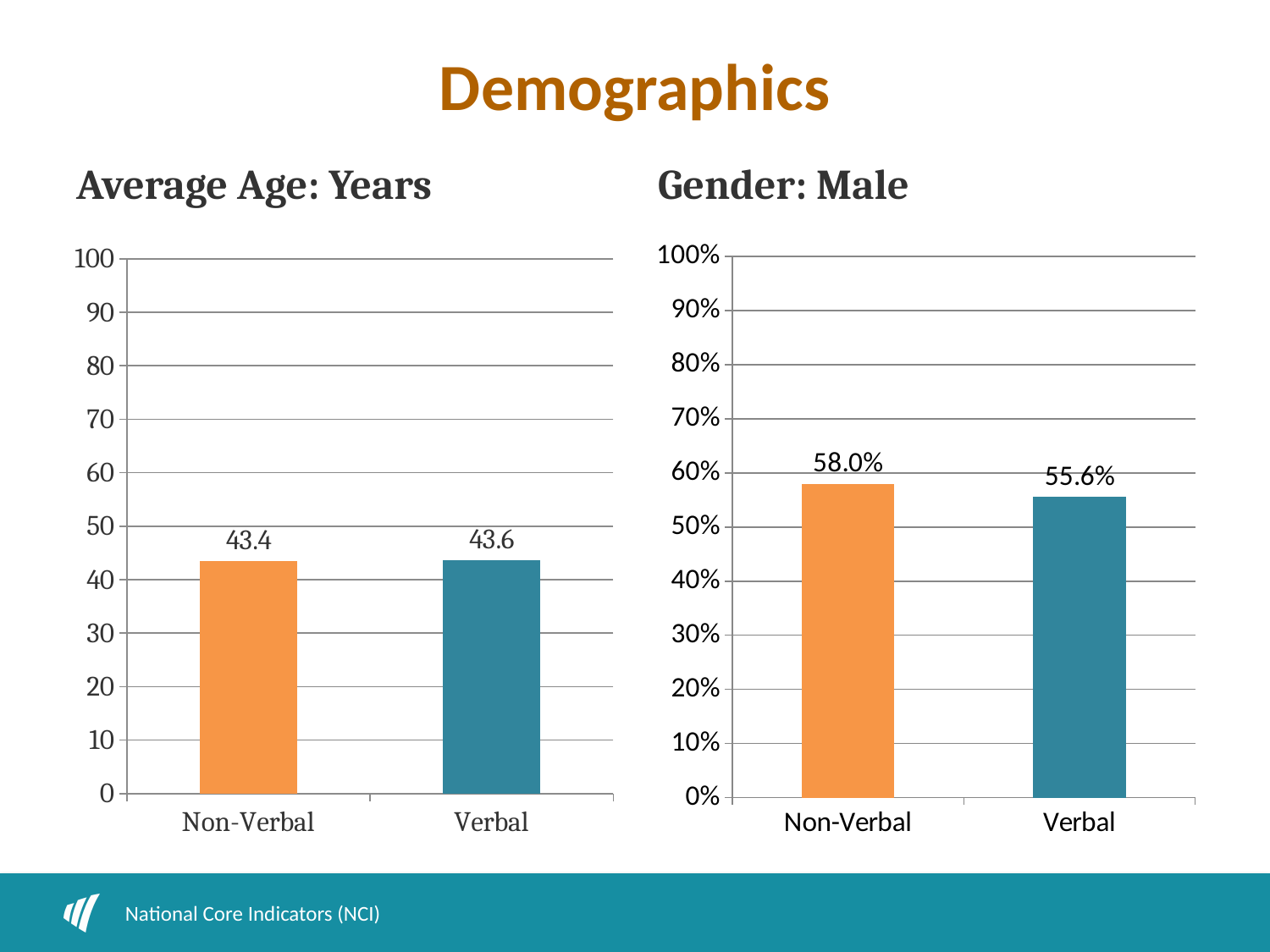
In the Gender: Male chart, is the value for Non-Verbal greater or less than 50%? greater In the Average Age: Years chart, what is the difference between the Verbal and Non-Verbal values? 0.2 In the Gender: Male chart, which category has the higher value? Non-Verbal In the Average Age: Years chart, what is the average age for Verbal? 43.6 In the Average Age: Years chart, is the value for Non-Verbal greater or less than 50? less In the Gender: Male chart, what percentage is shown for Verbal? 55.6% In the Gender: Male chart, what percentage is shown for Non-Verbal? 58.0% In the Average Age: Years chart, what is the average age for Non-Verbal? 43.4 In the Gender: Male chart, what is the difference between the Non-Verbal and Verbal values? 2.4% In the Gender: Male chart, which category has the lower value? Verbal What kind of chart is the Gender: Male chart? bar chart How many categories are shown in the Average Age: Years chart? 2